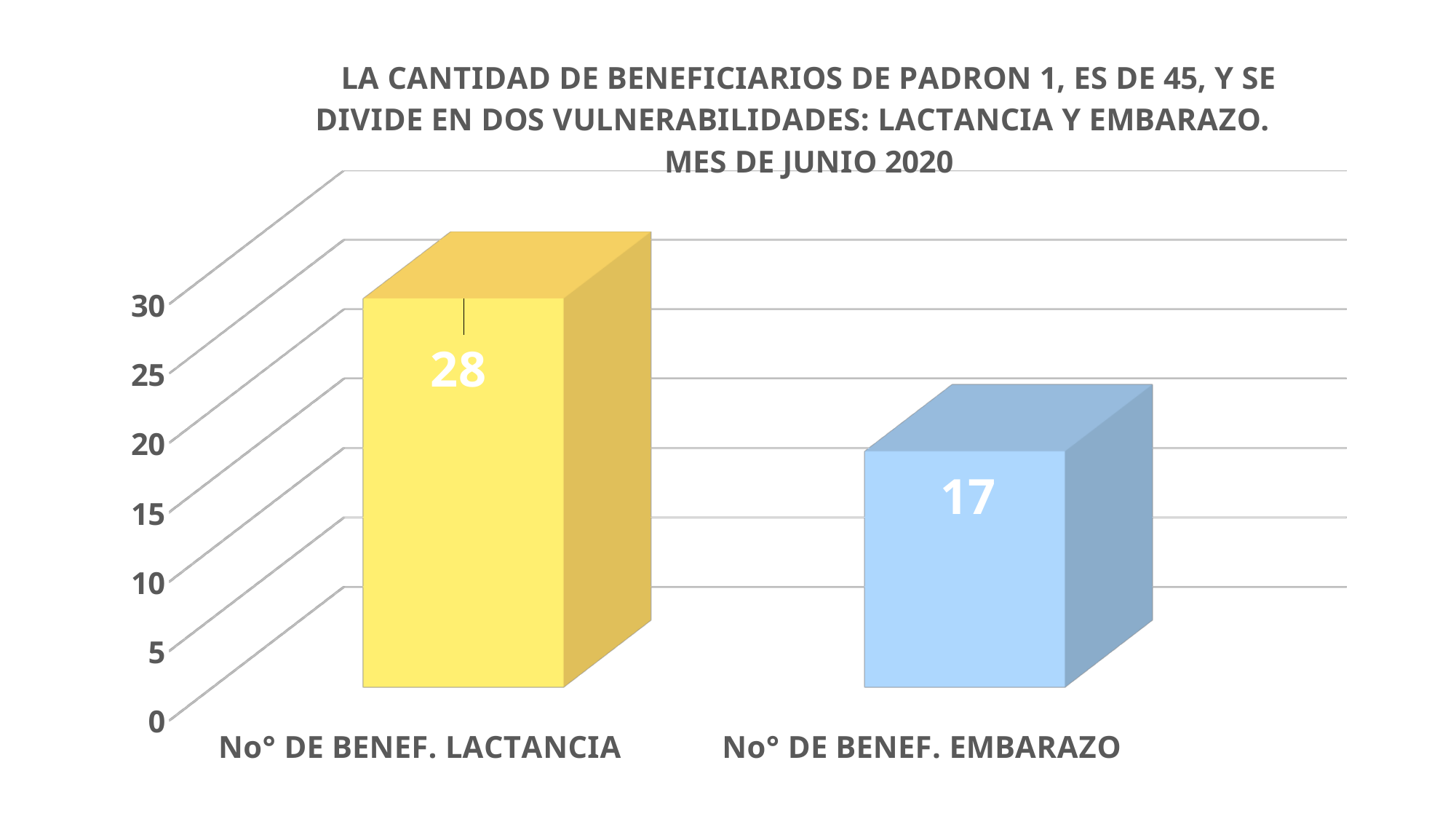
How many categories are shown in the chart? 2 What colour is the bar for No° DE BENEF. EMBARAZO? blue Which is larger, the value for No° DE BENEF. LACTANCIA or No° DE BENEF. EMBARAZO? No° DE BENEF. LACTANCIA What is the total of the two values shown in the chart? 45 Which category has the highest value? No° DE BENEF. LACTANCIA Which category has the lowest value? No° DE BENEF. EMBARAZO Is the value for No° DE BENEF. EMBARAZO greater or less than 20? less Is the value for No° DE BENEF. LACTANCIA greater or less than 25? greater What kind of chart is shown on the slide? bar chart What is the value for No° DE BENEF. LACTANCIA? 28 What is the difference between the values for No° DE BENEF. LACTANCIA and No° DE BENEF. EMBARAZO? 11 What is the value for No° DE BENEF. EMBARAZO? 17